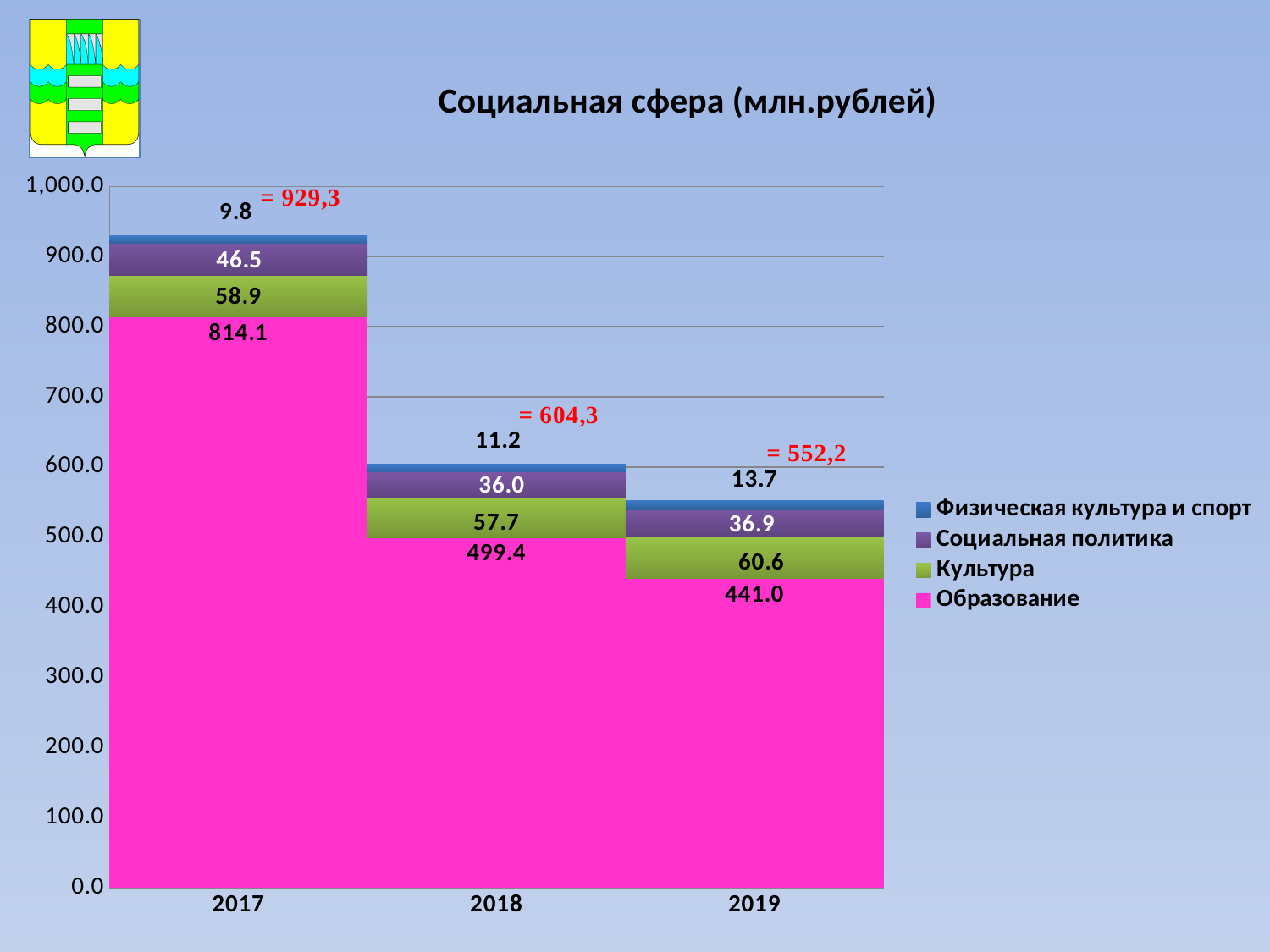
How many series does the legend list? 4 What is the value for Образование in 2017? 814.1 What is the value for Социальная политика in 2018? 36.0 What kind of chart is shown on the slide? Stacked bar chart What is the value for Культура in 2019? 60.6 What is the difference between the Образование values for 2017 and 2018? 314.7 What is the value for Физическая культура и спорт in 2019? 13.7 Which year has the lowest value for Физическая культура и спорт? 2017 How many years are shown on the x axis? 3 What is the total of the stacked bar for 2018? 604,3 Which is larger, the Культура value for 2017 or for 2018? 2017 Which year has the highest value for Образование? 2017